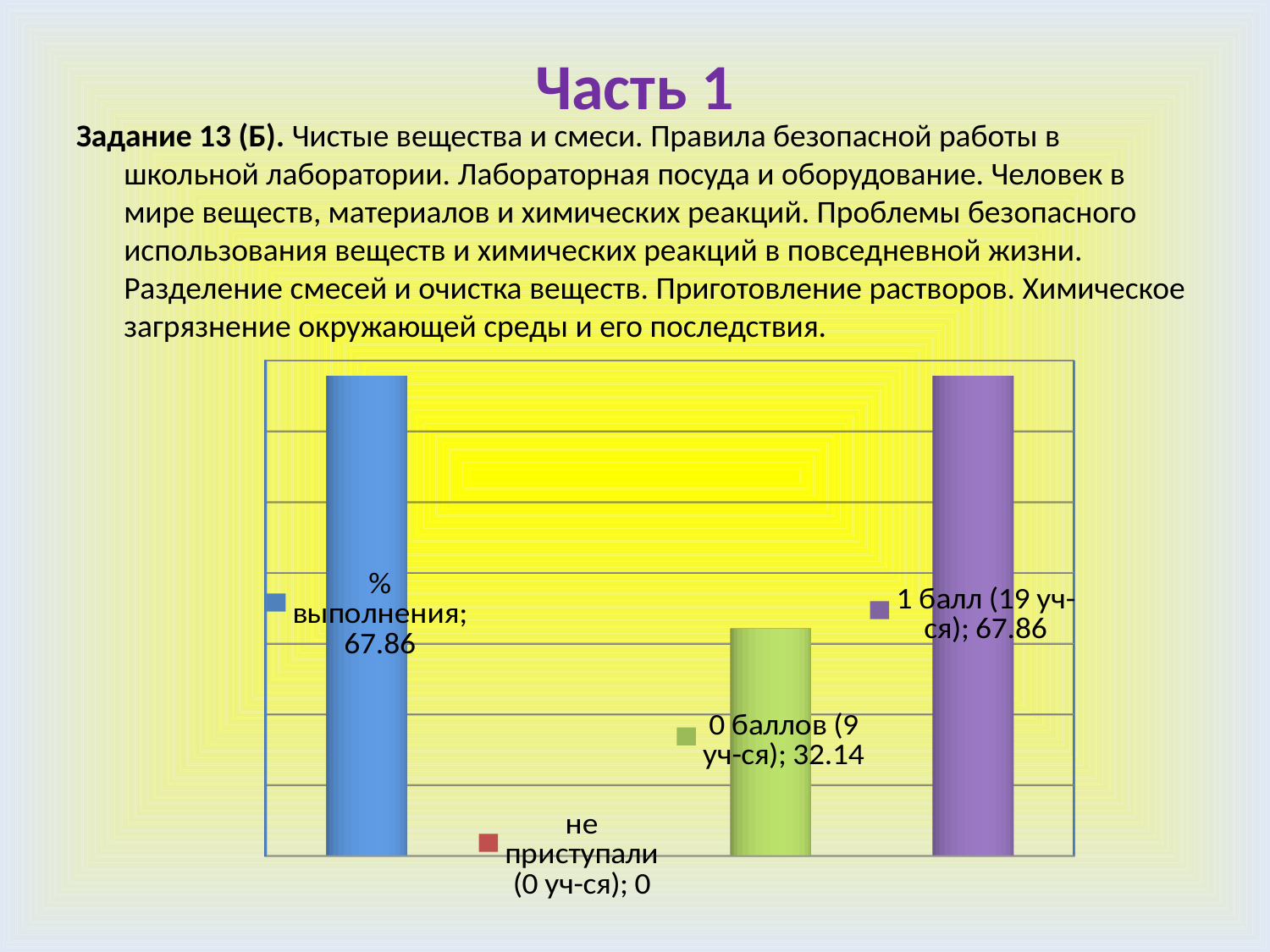
What is the value shown for "не приступали (0 уч-ся)"? 0 What kind of chart is shown on the slide? bar chart Which category has the lowest value in the chart? не приступали (0 уч-ся) What is the value shown for "0 баллов (9 уч-ся)"? 32.14 How many students are indicated in the label for the "1 балл" bar? 19 уч-ся How many bars are plotted in the chart? 3 Which is larger: the value for "1 балл (19 уч-ся)" or the value for "0 баллов (9 уч-ся)"? 1 балл (19 уч-ся) What is the difference between the values for "% выполнения" and "0 баллов (9 уч-ся)"? 35.72 What is the value shown for "% выполнения"? 67.86 What colour is the bar for "0 баллов (9 уч-ся)"? green What is the value shown for "1 балл (19 уч-ся)"? 67.86 What is the difference between the values for "1 балл (19 уч-ся)" and "0 баллов (9 уч-ся)"? 35.72